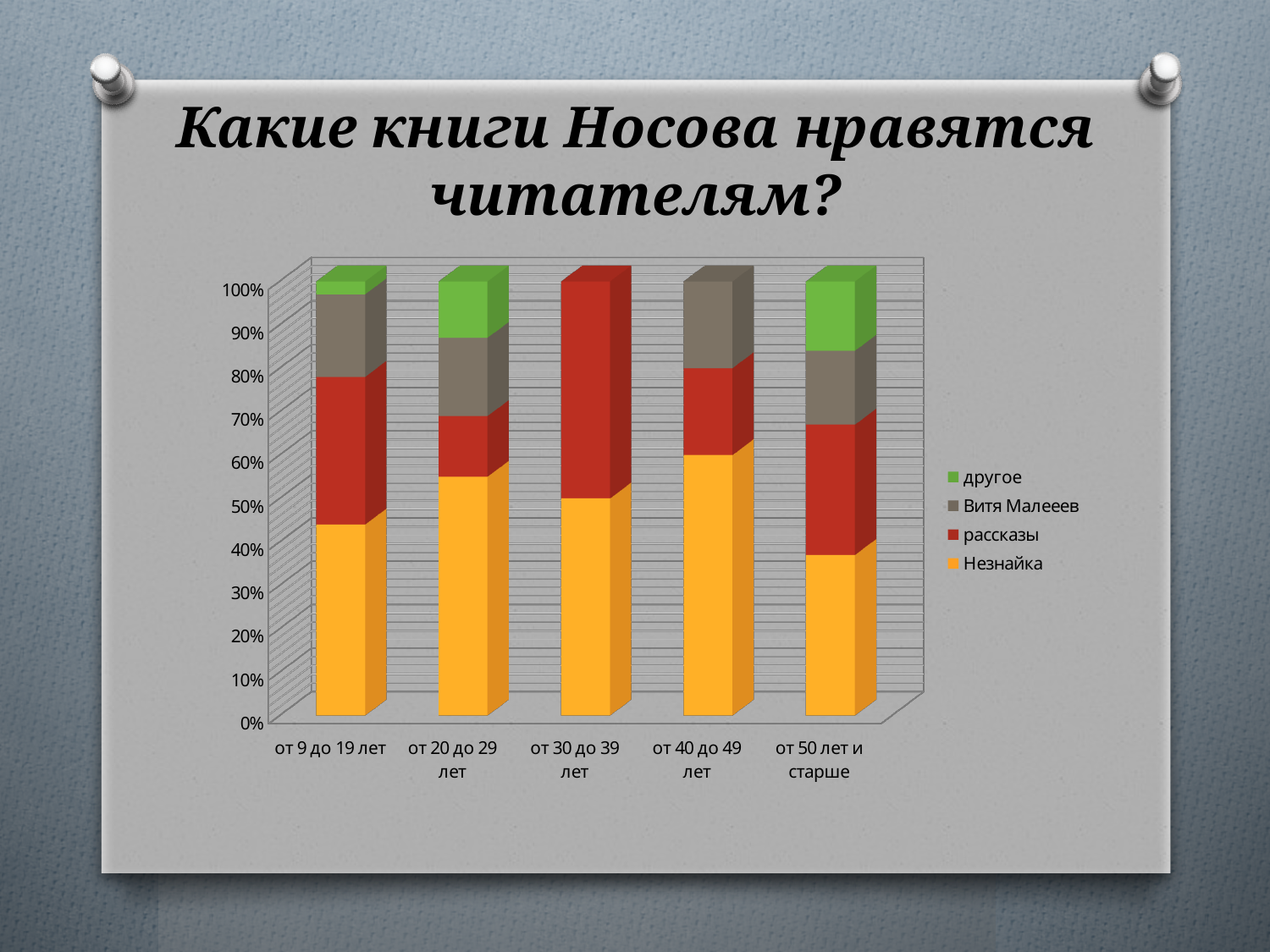
How many series does the chart legend list? 4 Is the share for "Незнайка" in the group "от 50 лет и старше" greater or less than 50%? less Is the share for "Незнайка" in the group "от 40 до 49 лет" greater or less than 50%? greater Which age group has the largest share for "рассказы"? от 30 до 39 лет Which age group has the smallest share for "рассказы"? от 20 до 29 лет Which group has a larger share for "рассказы": "от 30 до 39 лет" or "от 20 до 29 лет"? от 30 до 39 лет What is the title of the chart slide? Какие книги Носова нравятся читателям? Which age group has the smallest share for "Незнайка"? от 50 лет и старше Which colour represents the series "Незнайка" in the chart? Yellow/orange How many age groups are shown on the x axis of the chart? 5 What kind of chart is shown on the slide? Stacked bar chart Which age group has the largest share for "Незнайка"? от 40 до 49 лет